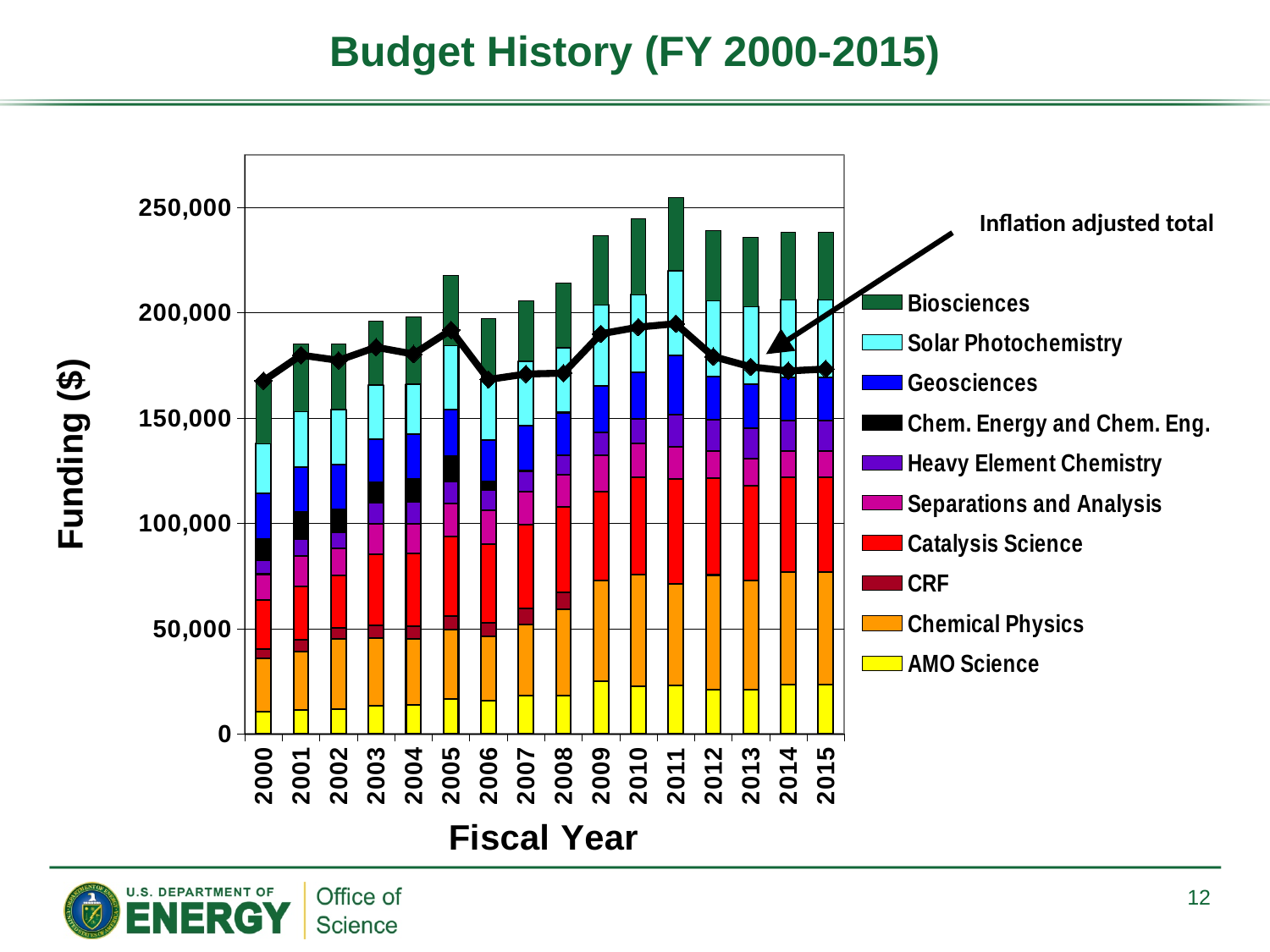
How many series does the legend list? 10 Which has the larger total funding, 2011 or 2000? 2011 What kind of chart is shown on the slide? Stacked bar chart with a line What does the black line with diamond markers represent? Inflation adjusted total Which fiscal year has the shortest stacked bar? 2000 Is the total funding for 2005 greater or less than 200,000? greater Which fiscal year has the tallest stacked bar? 2011 Is the total funding for 2011 greater or less than 250,000? greater Is the total funding for 2000 greater or less than 200,000? less Overall, does total funding rise or fall from 2000 to 2015? rise How many fiscal years are shown along the x axis? 16